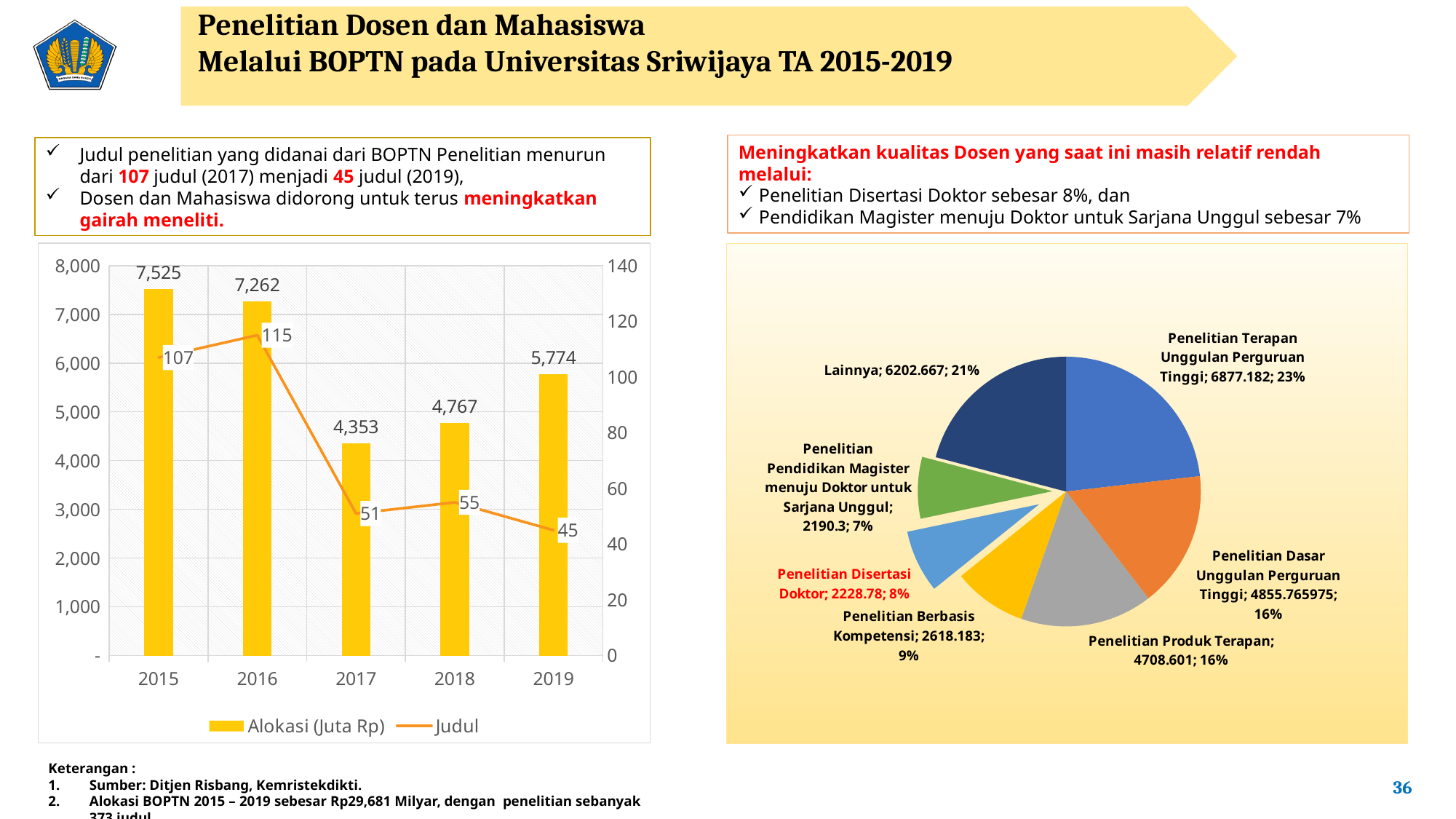
In the chart on the left of the slide, which year has the highest Judul value? 2016 In the chart on the left of the slide, how many series does the legend list? 2 In the pie chart on the right of the slide, what share does Lainnya have? 21% In the chart on the left of the slide, how many years are shown on the x axis? 5 In the pie chart on the right of the slide, which category has the largest share? Penelitian Terapan Unggulan Perguruan Tinggi In the chart on the left of the slide, what is the Alokasi (Juta Rp) value for 2015? 7,525 In the pie chart on the right of the slide, what is the value for Penelitian Disertasi Doktor? 2228.78 In the chart on the left of the slide, what is the difference between the Judul values for 2017 and 2019? 6 In the chart on the left of the slide, what is the Judul value for 2016? 115 In the chart on the left of the slide, is the Alokasi (Juta Rp) for 2018 larger or smaller than for 2019? smaller In the chart on the left of the slide, which year has the lowest Alokasi (Juta Rp)? 2017 What kind of chart is on the right of the slide? pie chart